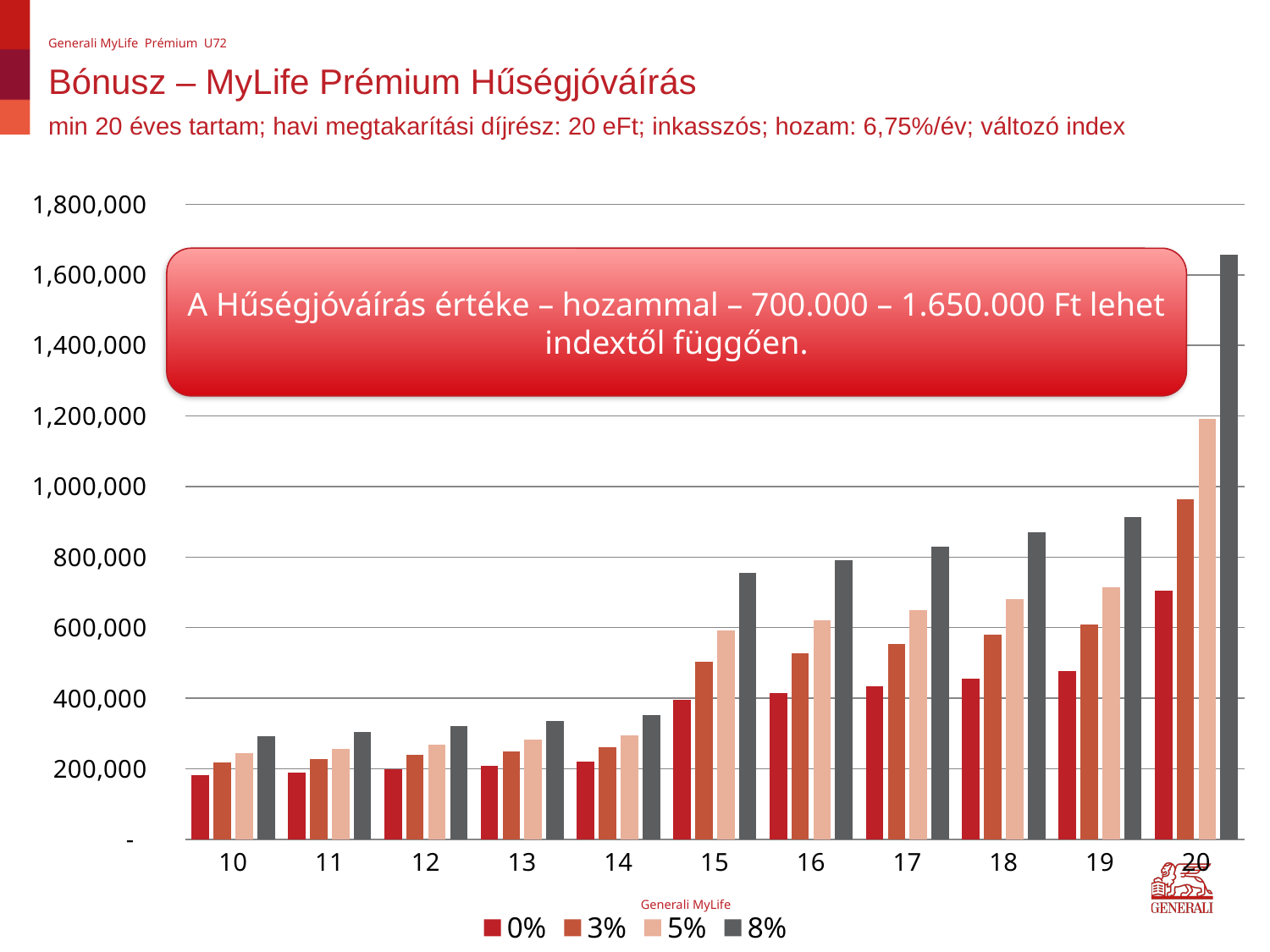
Which is larger: the 8% series at category 15 or the 5% series at category 20? 5% at category 20 Is the value of the 8% series at category 20 greater or less than 1,400,000? greater Which series has the tallest bar in category 20? 8% How many series does the legend list? 4 Is the value of the 8% series at category 15 greater or less than 600,000? greater How many categories are shown on the x axis? 11 Is the value of the 5% series at category 20 greater or less than 1,000,000? greater What kind of chart is shown on the slide? bar chart Do the values of the 8% series rise or fall from category 10 to category 20? rise Which series has the shortest bar in category 10? 0% What are the legend entries of the chart? 0%, 3%, 5%, 8%